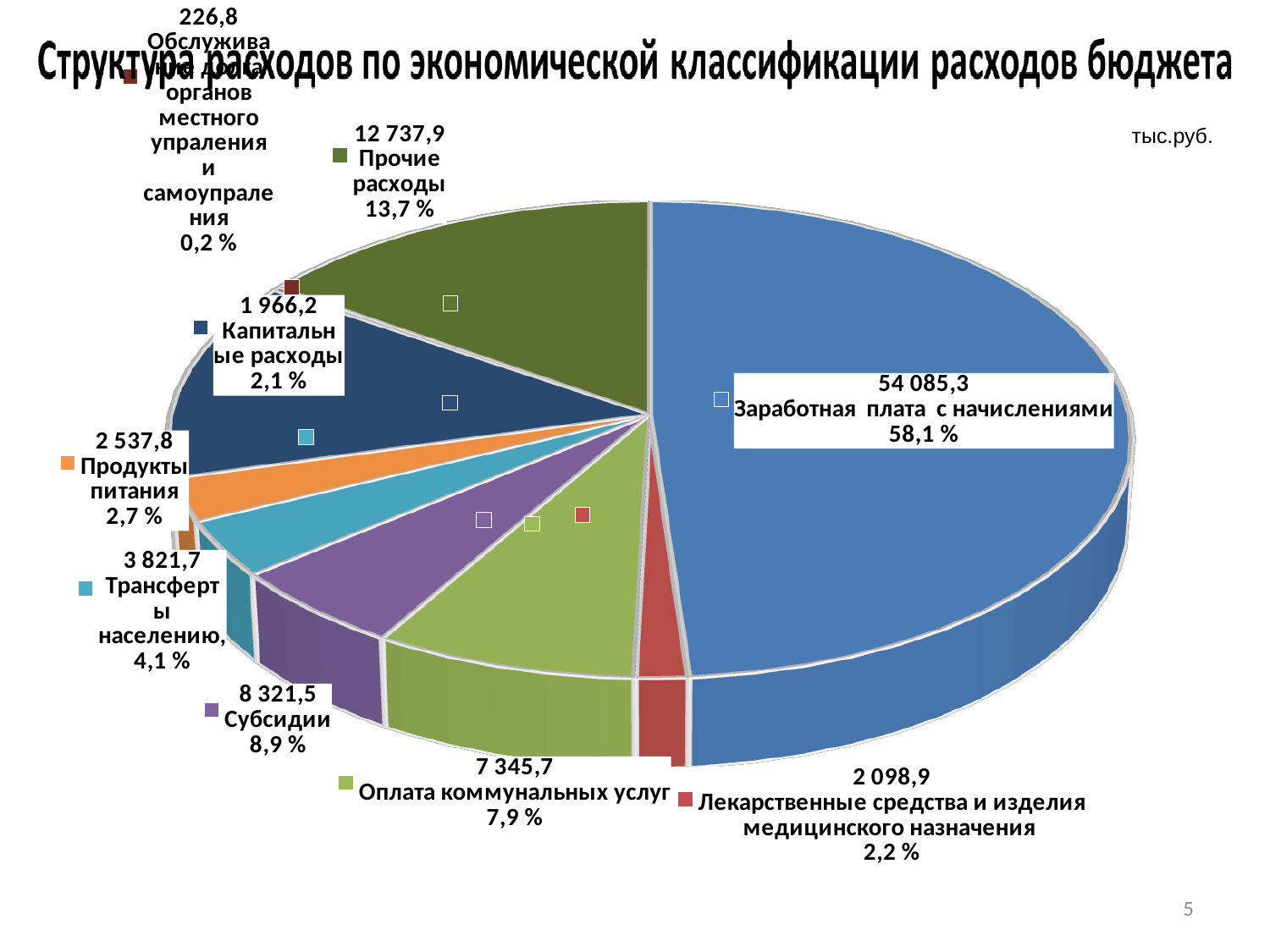
What share of the pie does Лекарственные средства и изделия медицинского назначения take? 2,2 % What is the value for Заработная плата с начислениями? 54 085,3 What is the value for Капитальные расходы? 1 966,2 What is the smallest value shown on the pie chart? 226,8 In what units are the values on the chart given? тыс.руб. Which is larger, Трансферты населению or Продукты питания? Трансферты населению What kind of chart is shown on the slide? pie chart What share of the pie does Прочие расходы take? 13,7 % What is the difference between the values for Субсидии and Оплата коммунальных услуг? 975,8 Which category has the largest slice of the pie? Заработная плата с начислениями How many slices does the pie chart have? 9 What is the value for Субсидии? 8 321,5